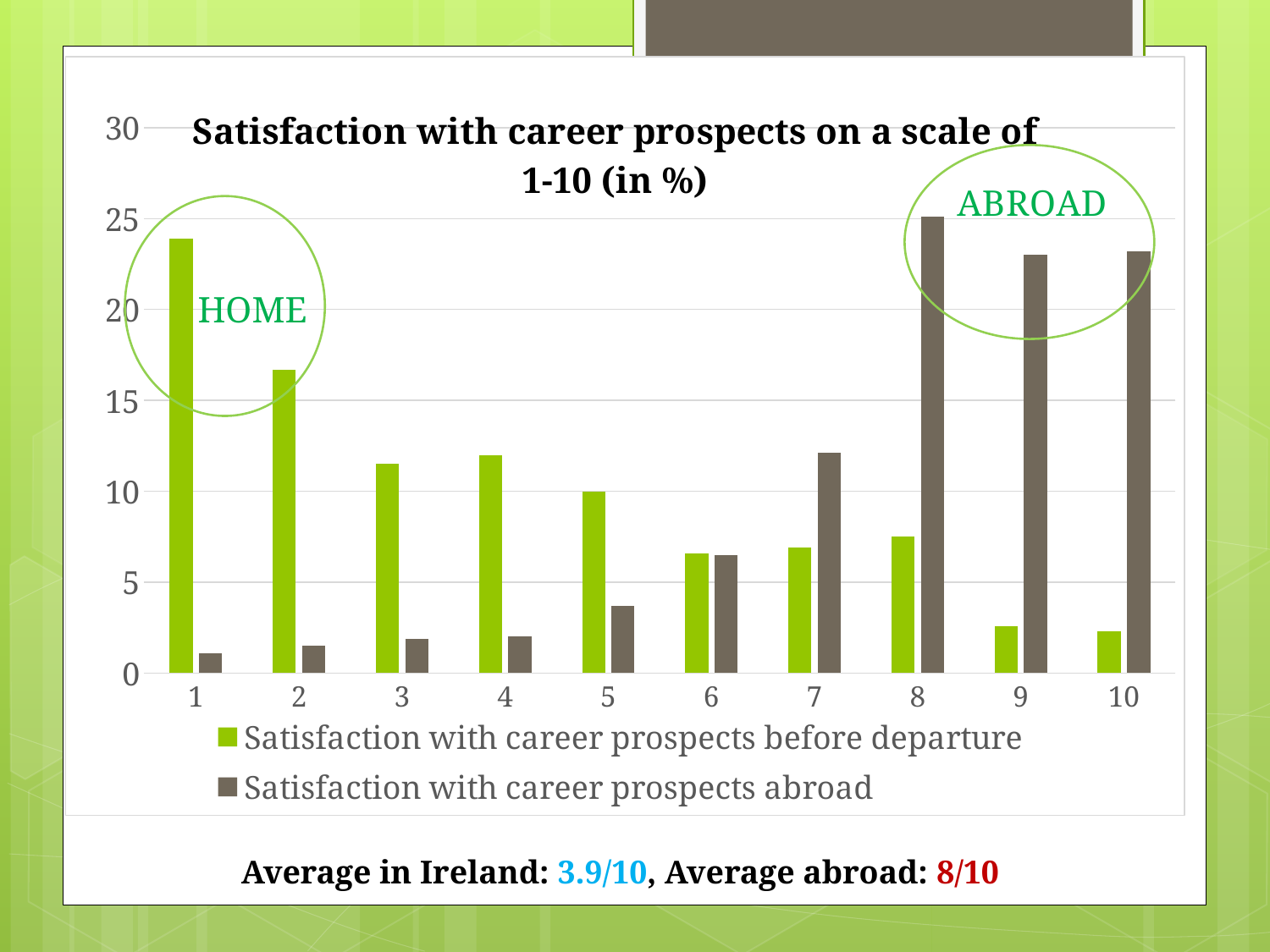
Which scale value has the highest bar for satisfaction with career prospects before departure? 1 What is the title of the chart? Satisfaction with career prospects on a scale of 1-10 (in %) Is the value for satisfaction with career prospects abroad at scale value 9 greater or less than 20? greater Which scale value has the highest bar for satisfaction with career prospects abroad? 8 Is the value for satisfaction with career prospects before departure at scale value 1 greater or less than 20? greater How many series does the legend list? 2 Is the value for satisfaction with career prospects abroad at scale value 1 greater or less than 5? less How many scale categories are shown along the x axis? 10 At scale value 8, which series has the larger value: before departure or abroad? abroad Do the values for satisfaction with career prospects abroad generally rise or fall from scale value 1 to 10? rise What kind of chart is shown on the slide? bar chart